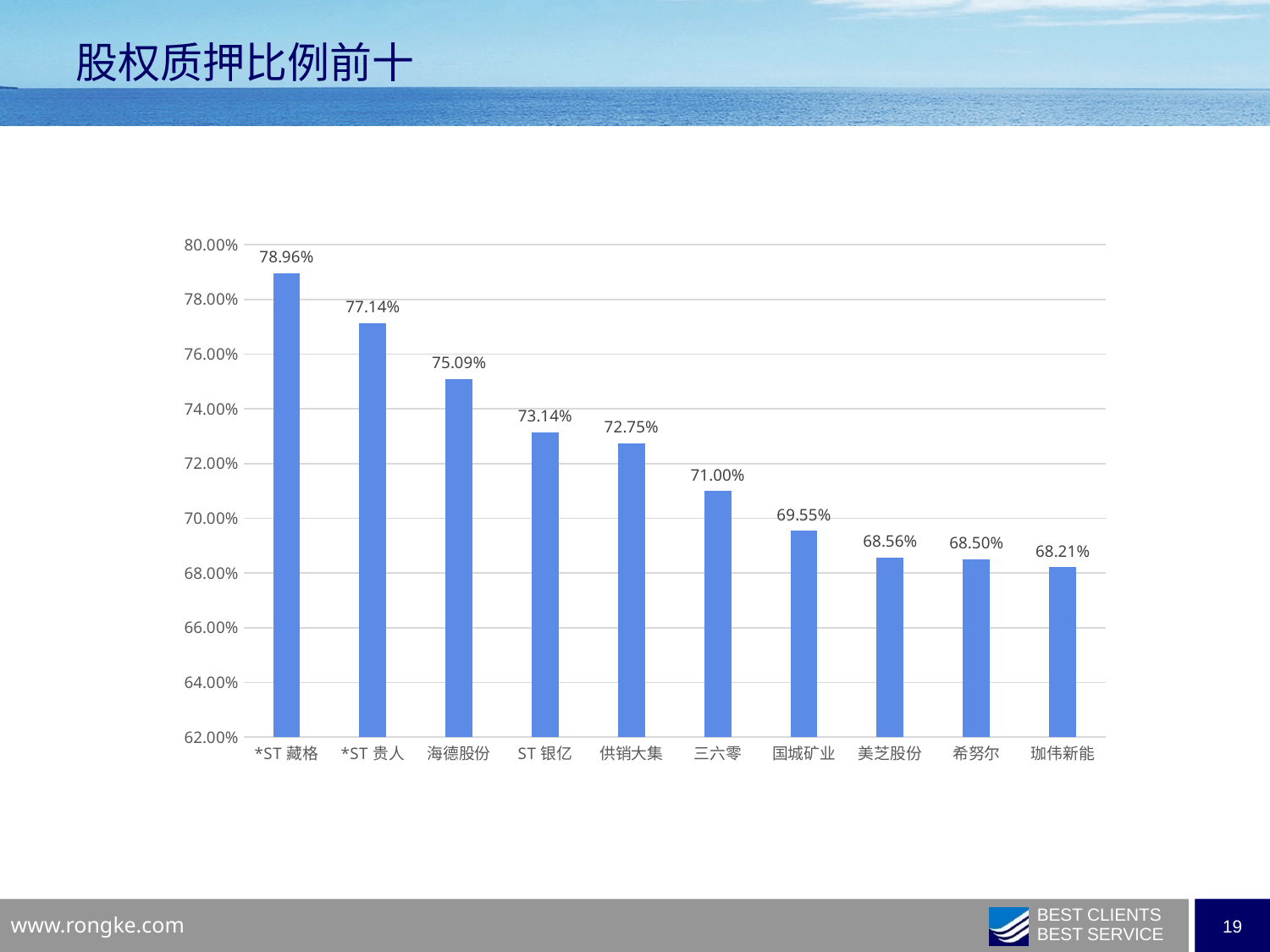
Which category has the highest value? *ST 藏格 How many categories are shown on the x axis? 10 What is the difference between the values for *ST 藏格 and 珈伟新能? 10.75 percentage points Is the value for 海德股份 greater or less than 74.00%? greater Do the values rise or fall from left to right along the x axis? Fall What is the value for *ST 藏格? 78.96% Which is larger, the value for *ST 贵人 or the value for 供销大集? *ST 贵人 Which category has the lowest value? 珈伟新能 What kind of chart is shown on the slide? Bar chart What is the value for 三六零? 71.00% What is the value for 国城矿业? 69.55% What is the difference between the values for 海德股份 and ST 银亿? 1.95 percentage points